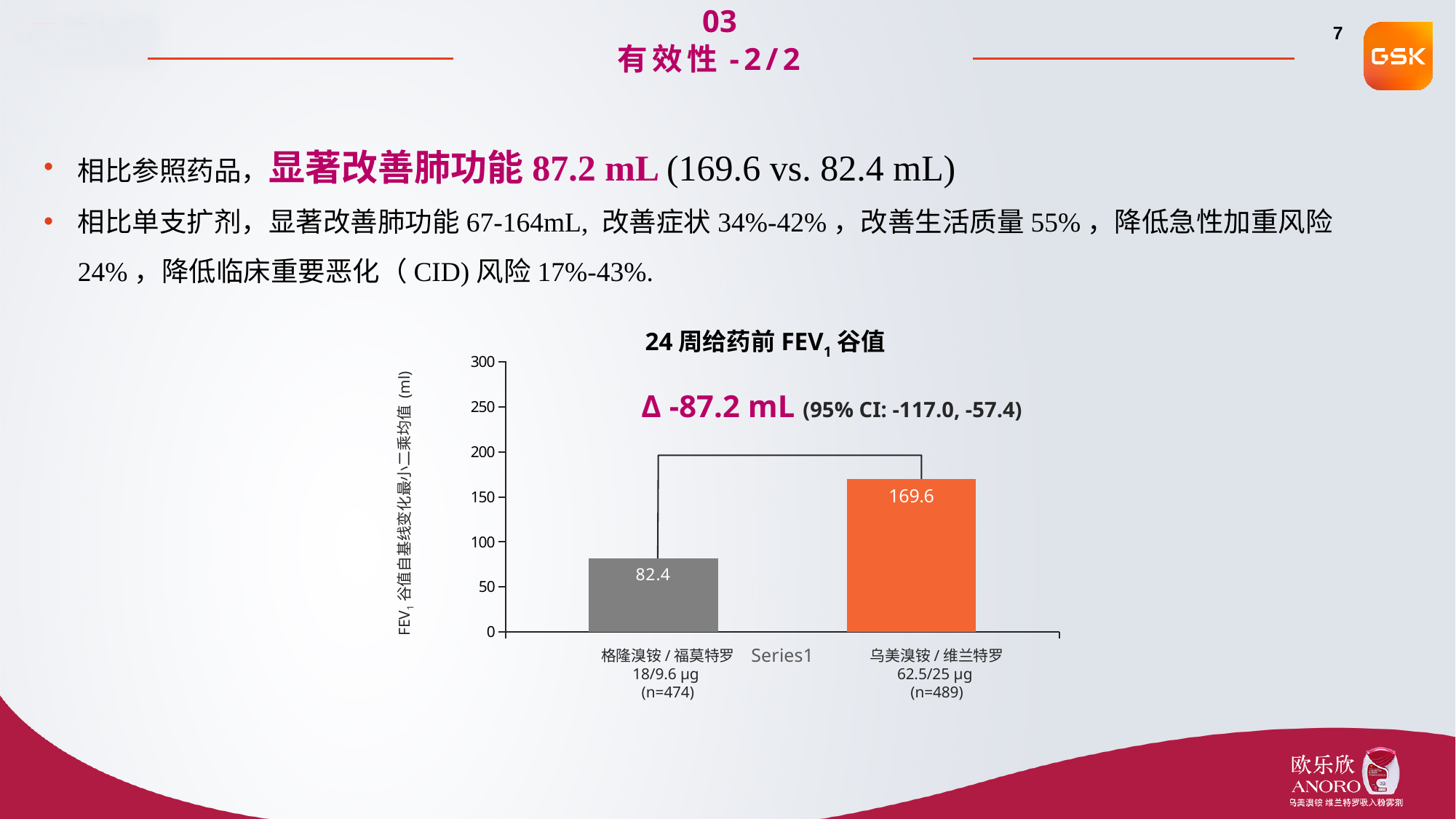
What is the value for 格隆溴铵 / 福莫特罗 18/9.6 µg (n=474) in the chart? 82.4 What is the difference between the values for 乌美溴铵 / 维兰特罗 and 格隆溴铵 / 福莫特罗? 87.2 How many bars are plotted in the chart? 2 What is the value for 乌美溴铵 / 维兰特罗 62.5/25 µg (n=489) in the chart? 169.6 Is the value for 乌美溴铵 / 维兰特罗 greater or less than 150? greater What is the maximum value shown on the chart's y axis? 300 Which group has the higher bar in the chart? 乌美溴铵 / 维兰特罗 62.5/25 µg (n=489) Is the value for 格隆溴铵 / 福莫特罗 greater or less than 100? less Which group has the lower bar in the chart? 格隆溴铵 / 福莫特罗 18/9.6 µg (n=474) What is the title of the chart? 24 周给药前 FEV1 谷值 What kind of chart is shown on the slide? bar chart Is the value for 乌美溴铵 / 维兰特罗 larger or smaller than the value for 格隆溴铵 / 福莫特罗? larger